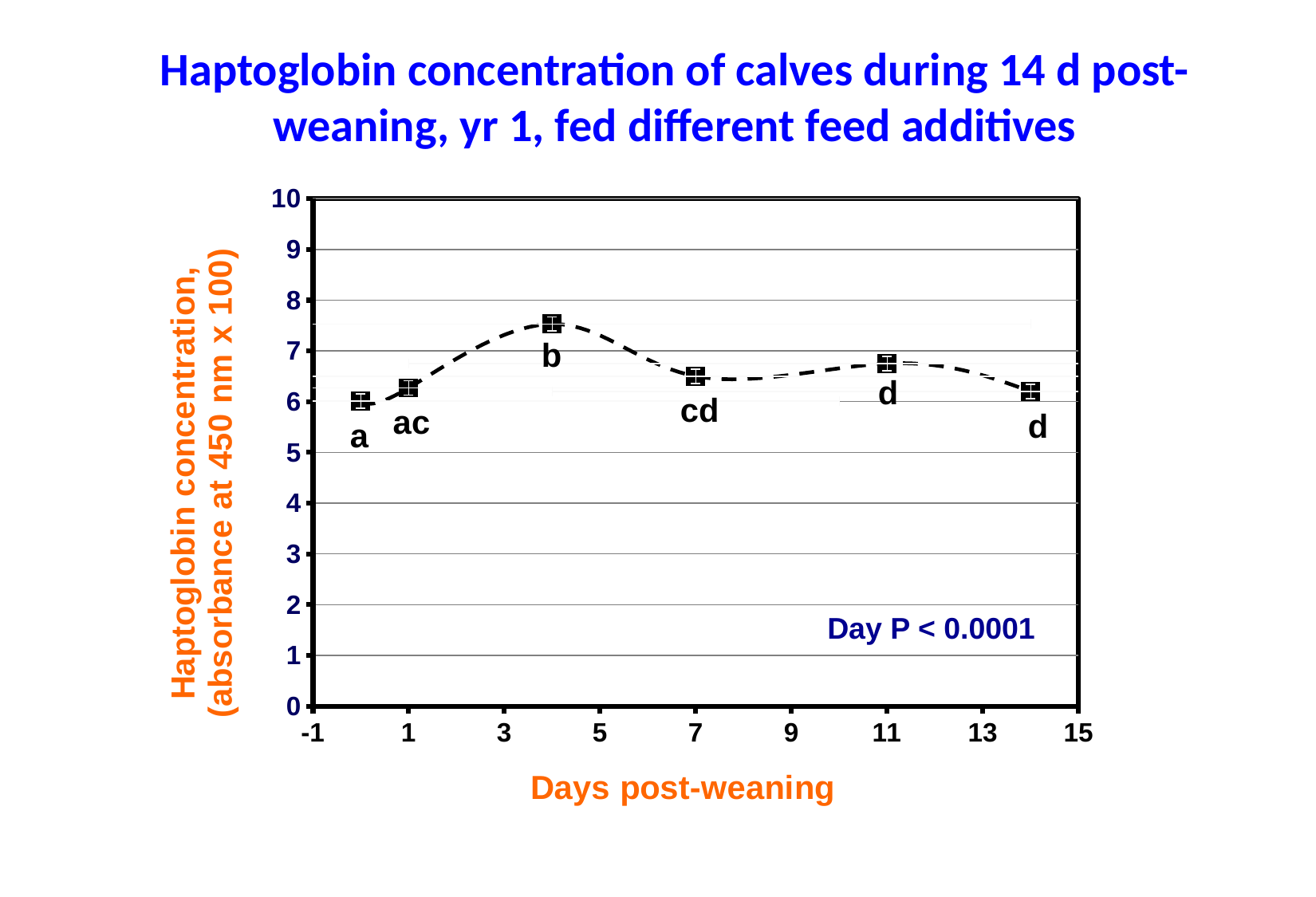
What is the label of the x axis? Days post-weaning How many data points are plotted on the chart? 6 What kind of chart is shown on the slide? line chart Is the haptoglobin concentration at day 7 greater or less than 7? less Which has the higher haptoglobin concentration, day 1 or day 11? day 11 At which day post-weaning is the haptoglobin concentration highest? 4 Is the haptoglobin concentration at day 4 greater or less than 7? greater Which has the higher haptoglobin concentration, day 4 or day 7? day 4 What P value for day is stated on the chart? Day P < 0.0001 Is the haptoglobin concentration at day 11 greater or less than 7? less Does the haptoglobin concentration rise or fall between day 4 and day 7? fall